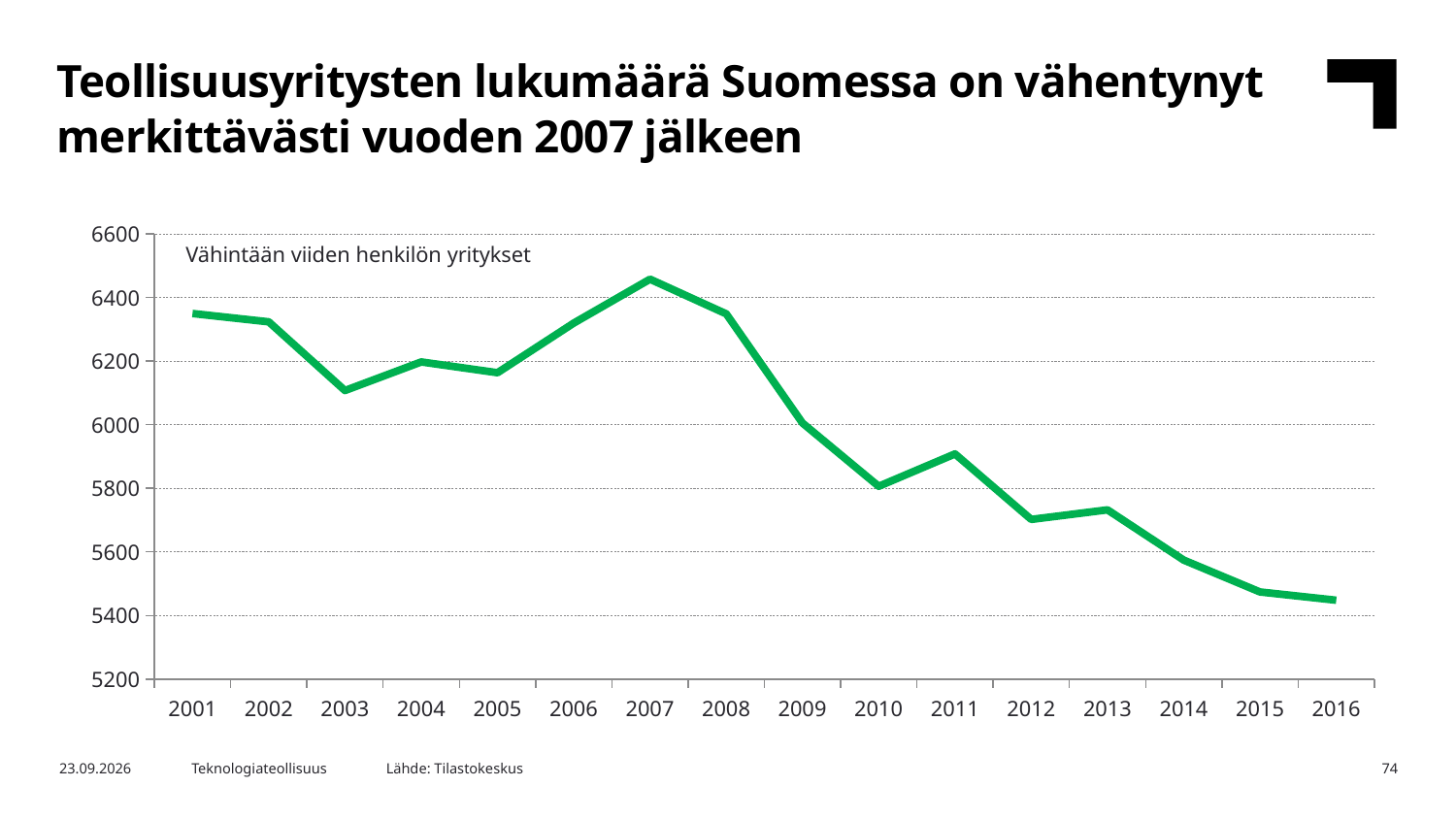
Is the value for 2003 greater or less than 6200? less Is the value for 2016 greater or less than 5600? less What kind of chart is shown on the slide? Line chart How many years are plotted along the x axis? 16 What text label appears inside the plot area of the chart? Vähintään viiden henkilön yritykset In which year is the number of industrial companies lowest? 2016 In which year is the number of industrial companies highest? 2007 Is the value for 2012 greater or less than 5800? less Do the values generally rise or fall from 2007 to 2016? Fall Which year has a higher value, 2010 or 2011? 2011